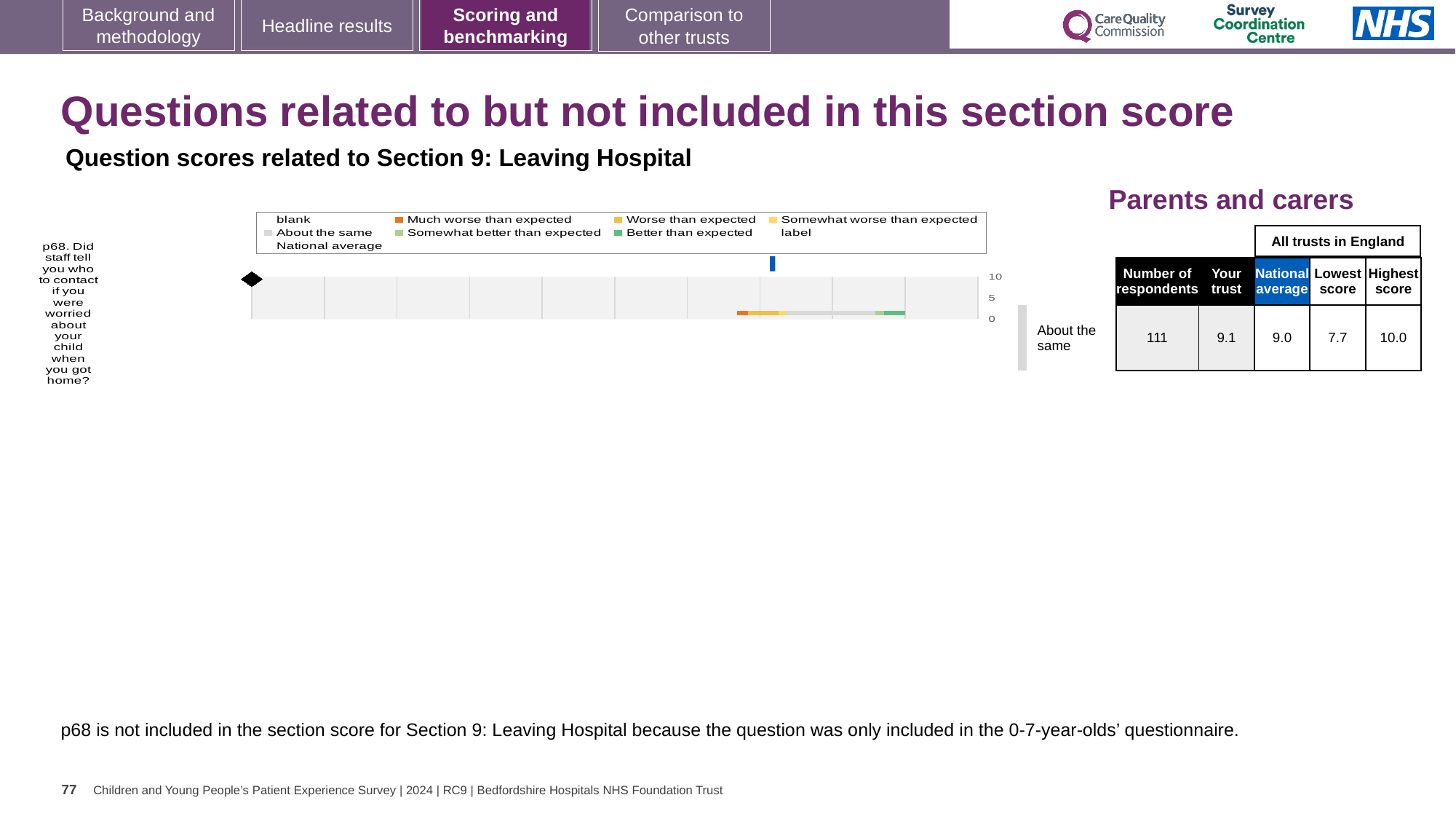
What is the 'Your trust' score for p68 in the table? 9.1 What is the highest score among all trusts in England for p68? 10.0 Which question number is plotted in the chart? p68 What rating category is shown next to the chart for p68? About the same Is the 'Your trust' score for p68 greater or less than 5? greater What is the difference between the highest score and the lowest score for p68? 2.3 What is the national average score for p68? 9.0 What is the lowest score among all trusts in England for p68? 7.7 What kind of chart is shown for question p68? bar chart How many respondents answered p68? 111 How many questions are plotted in the chart? 1 Which is larger for p68, the 'Your trust' score or the national average? Your trust